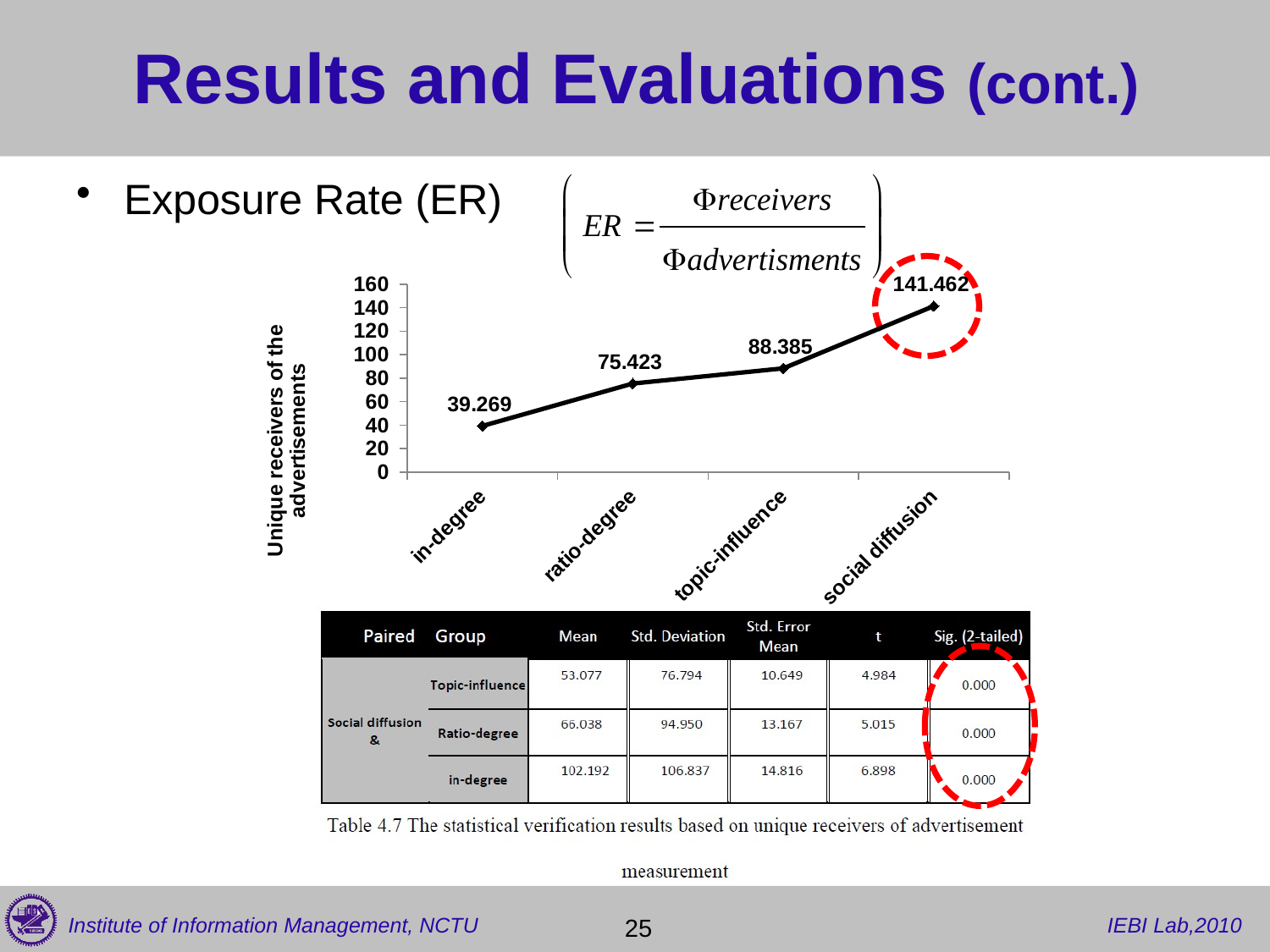
What is the value for in-degree in the line chart? 39.269 What kind of chart is shown on the slide? line chart Which category has the lowest value in the line chart? in-degree Which category has the highest value in the line chart? social diffusion What is the value for topic-influence in the line chart? 88.385 Do the values in the line chart rise or fall from in-degree to social diffusion? rise What is the difference between the values for social diffusion and in-degree in the line chart? 102.193 Is the value for social diffusion in the line chart greater or less than 140? greater What is the value for social diffusion in the line chart? 141.462 How many categories are plotted on the x axis of the line chart? 4 Which is larger in the line chart, the value for ratio-degree or the value for topic-influence? topic-influence What is the value for ratio-degree in the line chart? 75.423